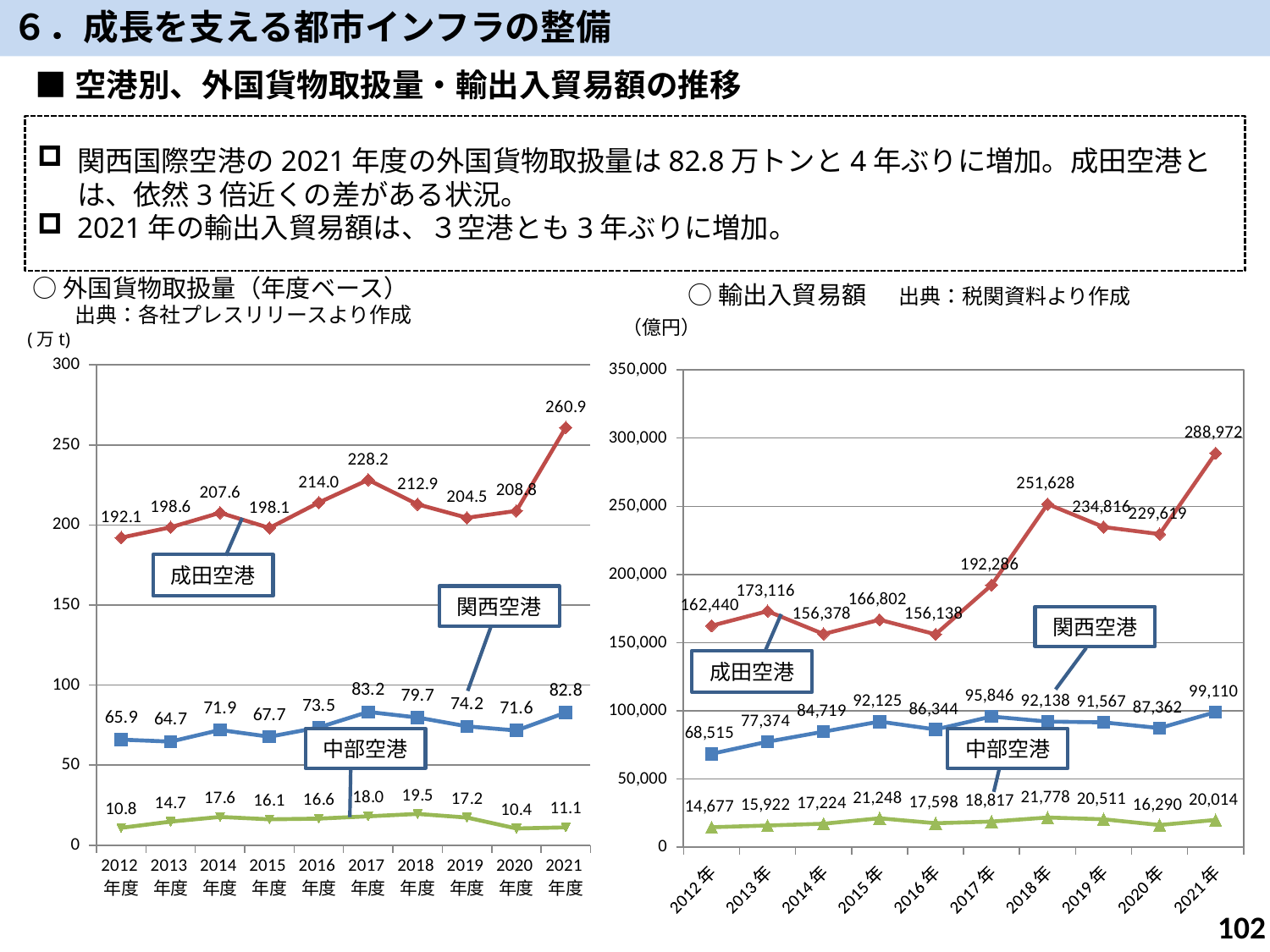
In the right chart (輸出入貿易額), which is larger for 成田空港: the value in 2018年 or the value in 2019年? 2018年 In the right chart (輸出入貿易額), what is the value for 成田空港 in 2021年? 288,972 In the left chart (外国貨物取扱量), how many years are shown on the x axis? 10 What type of chart is the left chart (外国貨物取扱量)? line chart How many airport series are plotted in the right chart (輸出入貿易額)? 3 In the left chart (外国貨物取扱量), in which year is the 中部空港 value lowest? 2020年度 In the left chart (外国貨物取扱量), what is the value for 関西空港 in 2021年度? 82.8 In the right chart (輸出入貿易額), is the value for 関西空港 in 2012年 greater or less than 100,000? less In the right chart (輸出入貿易額), in which year is the 関西空港 value highest? 2021年 In the left chart (外国貨物取扱量), what is the difference between 成田空港 and 関西空港 in 2021年度? 178.1 In the right chart (輸出入貿易額), what is the value for 中部空港 in 2015年? 21,248 In the left chart (外国貨物取扱量), what is the value for 成田空港 in 2017年度? 228.2